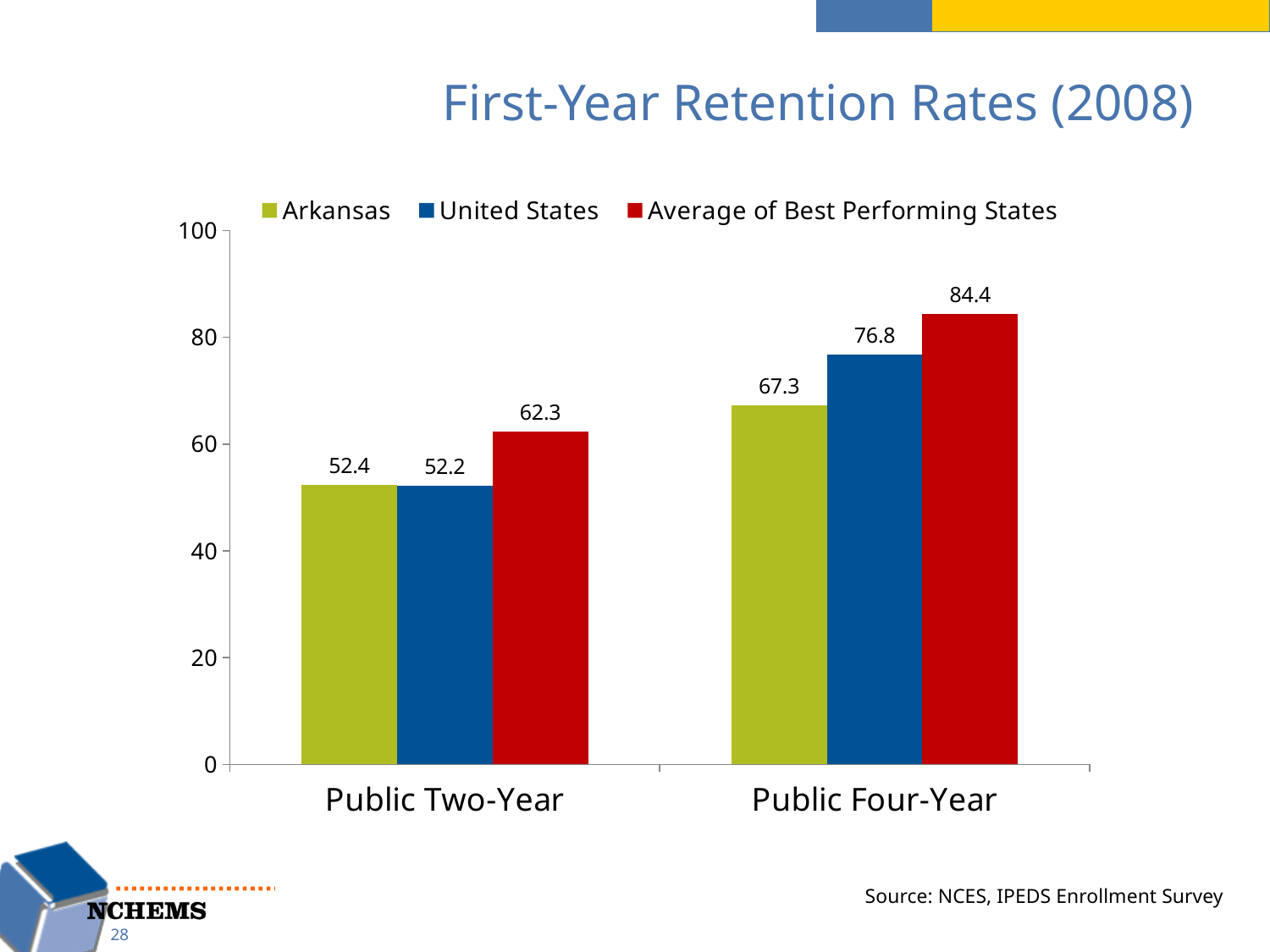
Which series has the highest value for Public Four-Year institutions? Average of Best Performing States Is the Arkansas value for Public Four-Year institutions greater or less than 60? greater What is the difference between the Average of Best Performing States and Arkansas at Public Four-Year institutions? 17.1 What is the first-year retention rate for the United States at Public Four-Year institutions? 76.8 What is the difference between the Average of Best Performing States and the United States at Public Two-Year institutions? 10.1 What is the value for Average of Best Performing States at Public Four-Year institutions? 84.4 What is the title of the chart? First-Year Retention Rates (2008) What kind of chart is shown on the slide? Bar chart What is the first-year retention rate for Arkansas at Public Two-Year institutions? 52.4 Which series has the lowest value for Public Two-Year institutions? United States How many series does the legend list? 3 What is the value for Average of Best Performing States at Public Two-Year institutions? 62.3